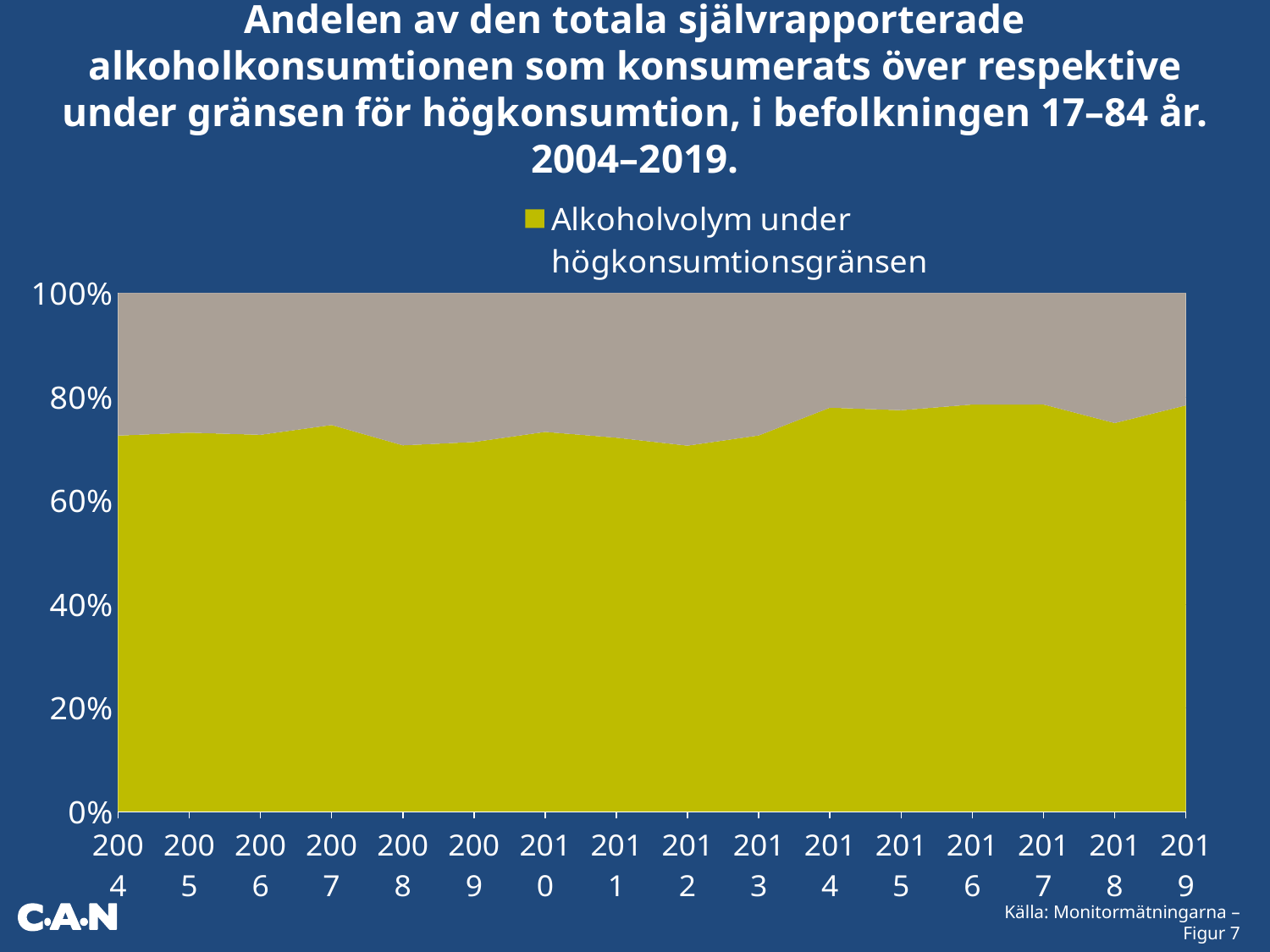
Is the value for Alkoholvolym under högkonsumtionsgränsen in 2019 greater or less than 80%? less Which is the first year shown on the x axis? 2004 How many years are plotted along the x axis? 16 Which year has the larger value for Alkoholvolym under högkonsumtionsgränsen, 2012 or 2014? 2014 Is the value for Alkoholvolym under högkonsumtionsgränsen in 2012 greater or less than 60%? greater What kind of chart is shown on the slide? area chart Overall, does the share for Alkoholvolym under högkonsumtionsgränsen rise or fall from 2004 to 2019? rise What do the two stacked areas add up to in each year? 100% What colour is the series Alkoholvolym under högkonsumtionsgränsen? yellow Which year has the larger value for Alkoholvolym under högkonsumtionsgränsen, 2007 or 2008? 2007 Which is the last year shown on the x axis? 2019 Is the value for Alkoholvolym under högkonsumtionsgränsen in 2004 greater or less than 80%? less